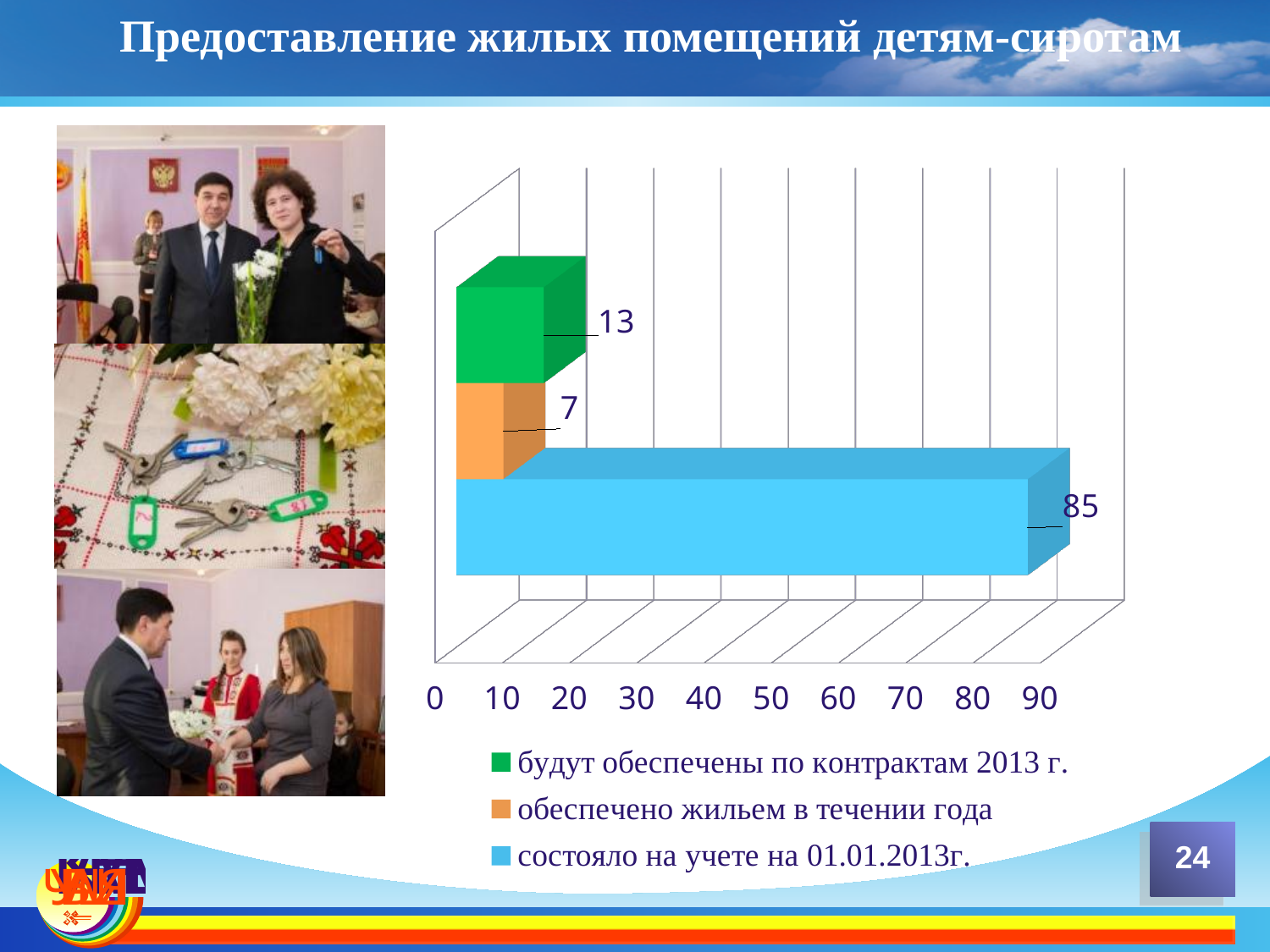
Which series has the lowest value? обеспечено жильем в течении года Which series has the highest value? состояло на учете на 01.01.2013г. What value is shown for "состояло на учете на 01.01.2013г."? 85 What value is shown for "будут обеспечены по контрактам 2013 г."? 13 Which is larger: the value for "будут обеспечены по контрактам 2013 г." or the value for "обеспечено жильем в течении года"? будут обеспечены по контрактам 2013 г. Is the value for "состояло на учете на 01.01.2013г." greater or less than 80? greater What colour is the bar for "состояло на учете на 01.01.2013г."? blue What value is shown for "обеспечено жильем в течении года"? 7 How many series does the legend list? 3 What is the difference between the value for "будут обеспечены по контрактам 2013 г." and the value for "обеспечено жильем в течении года"? 6 What is the difference between the value for "состояло на учете на 01.01.2013г." and the value for "будут обеспечены по контрактам 2013 г."? 72 What kind of chart is shown on the slide? bar chart